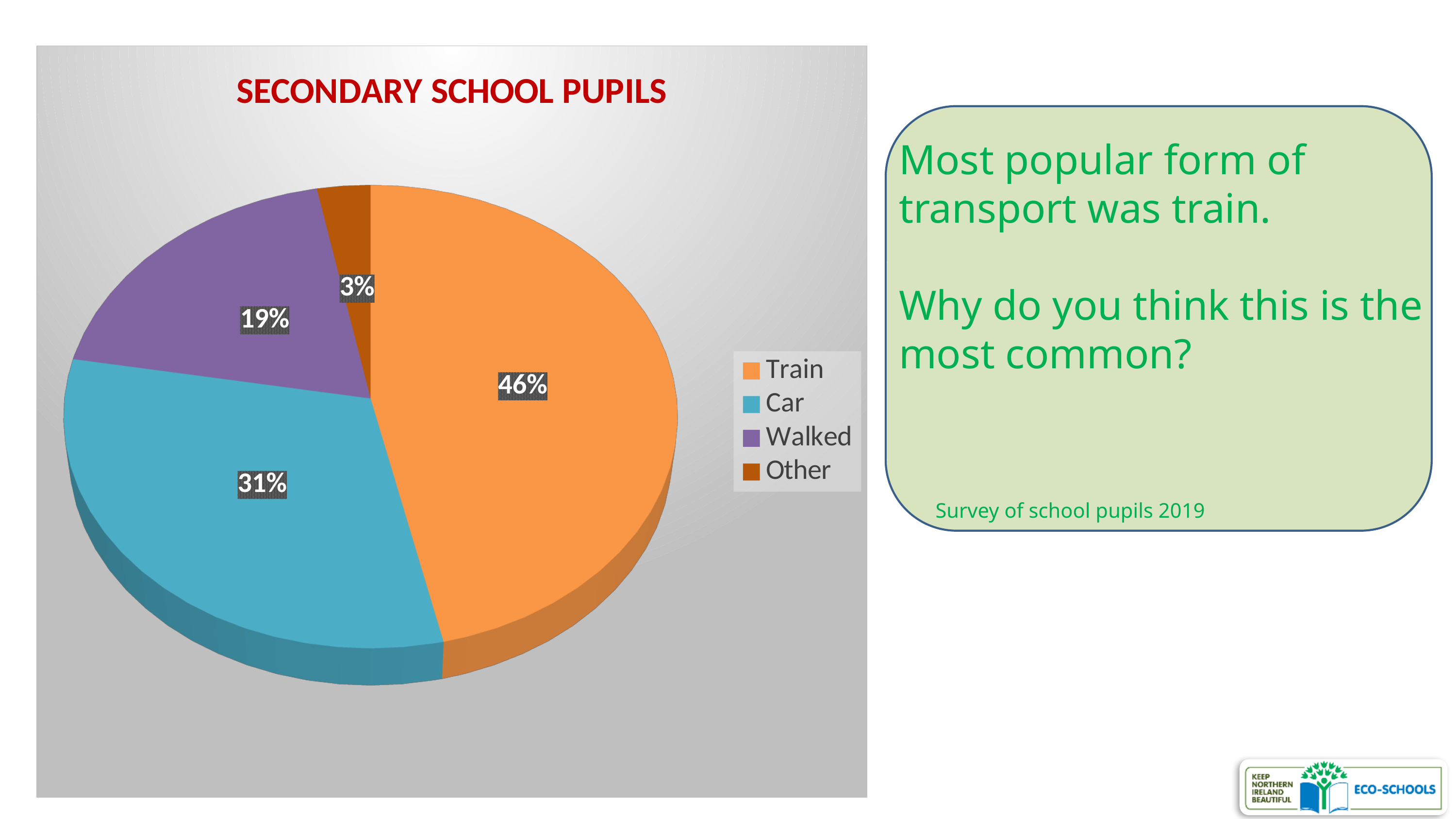
How many categories are shown in the pie chart? 4 What percentage of secondary school pupils travelled by train? 46% What percentage of secondary school pupils used 'Other' forms of transport? 3% What is the difference in percentage points between the Train and Car slices? 15 Which is larger, the share for Car or the share for Walked? Car What colour is the Walked slice in the pie chart? Purple What percentage of secondary school pupils walked? 19% Which form of transport has the smallest share of the pie? Other What kind of chart is shown on the slide? Pie chart What percentage of secondary school pupils travelled by car? 31% What is the title of the chart? SECONDARY SCHOOL PUPILS Which form of transport has the largest share of the pie? Train